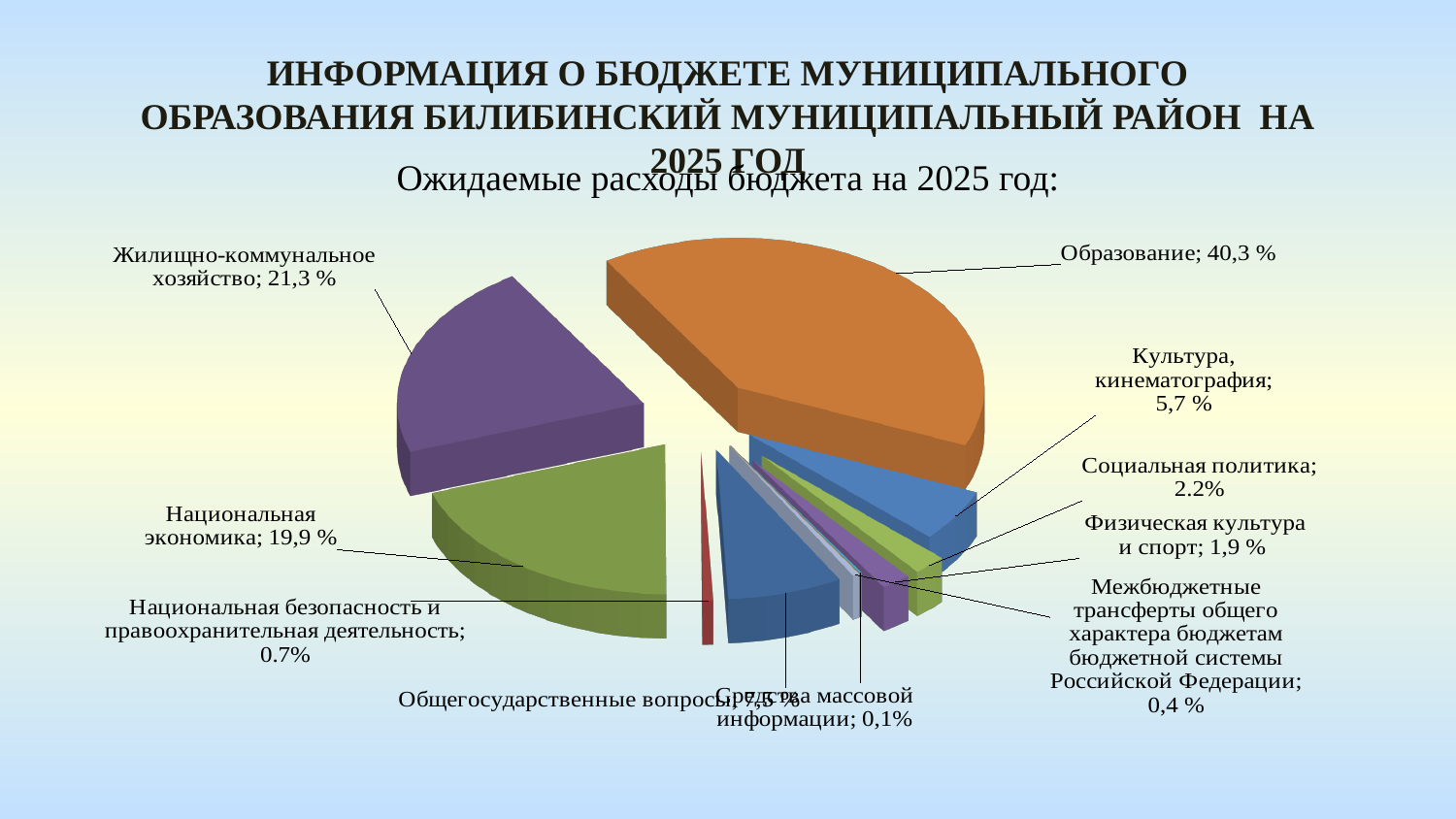
How many categories are shown in the pie chart? 10 What type of chart is shown on the slide? Pie chart Which category has the largest share of the pie? Образование Which is larger, Жилищно-коммунальное хозяйство or Национальная экономика? Жилищно-коммунальное хозяйство What is the value for Культура, кинематография? 5,7 % What share is shown for Физическая культура и спорт? 1,9 % What is the value shown for Жилищно-коммунальное хозяйство? 21,3 % Which category has the smallest share of the pie? Средства массовой информации What is the value for Средства массовой информации? 0,1% What is the difference between the shares of Жилищно-коммунальное хозяйство and Национальная экономика? 1,4 % What share of the pie does Образование account for? 40,3 % What percentage is labelled for Национальная экономика? 19,9 %